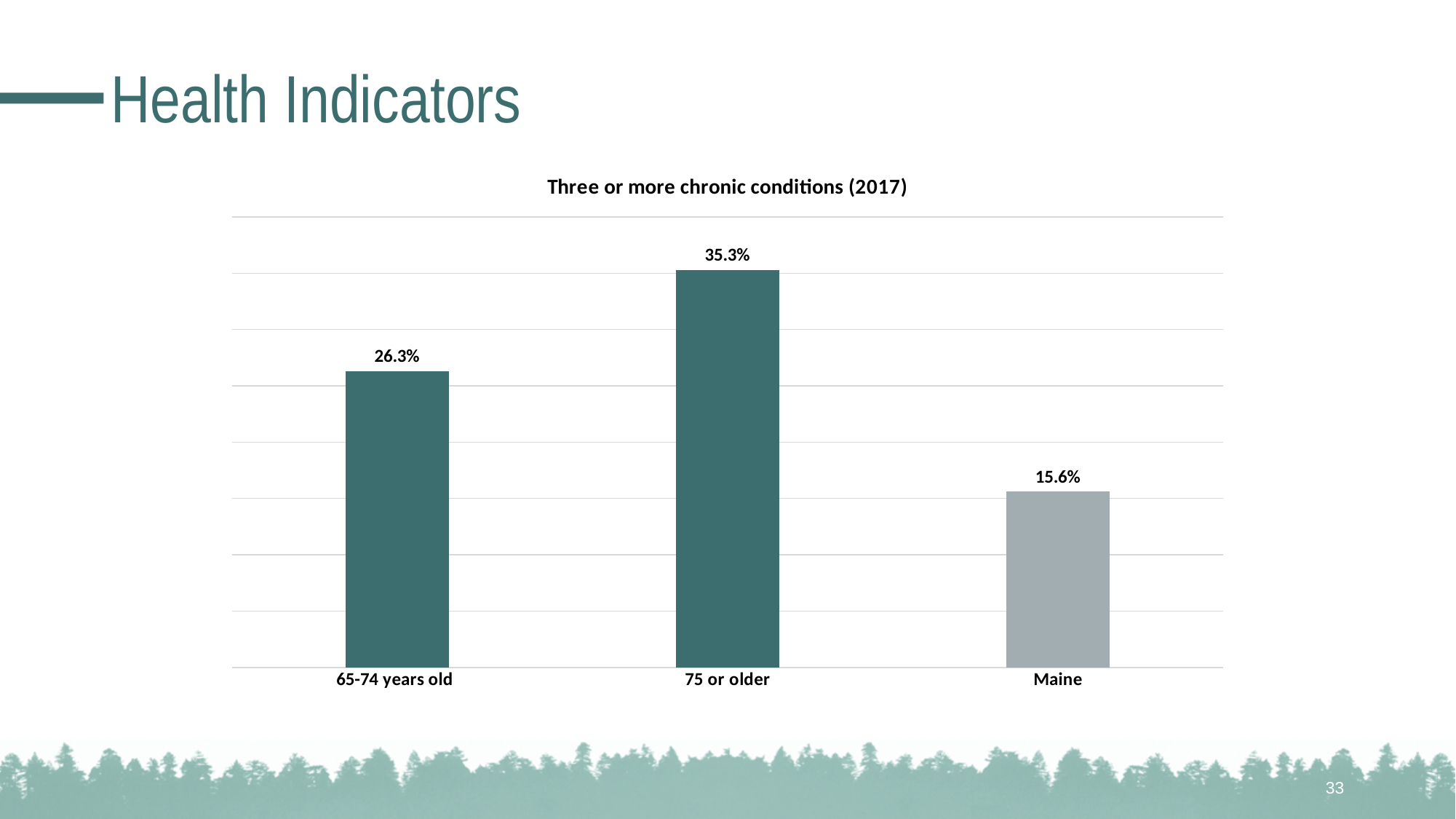
What is the difference between the values for 75 or older and 65-74 years old? 9.0% What is the value for 65-74 years old? 26.3% Which is larger, the value for 65-74 years old or the value for Maine? 65-74 years old Which category has the lowest value? Maine What is the value for Maine? 15.6% What is the title of the chart? Three or more chronic conditions (2017) How many categories are shown in the chart? 3 Which category has the highest value? 75 or older What is the value for 75 or older? 35.3% What is the difference between the values for 65-74 years old and Maine? 10.7% What kind of chart is shown on the slide? Bar chart Which bar is coloured grey rather than dark teal? Maine